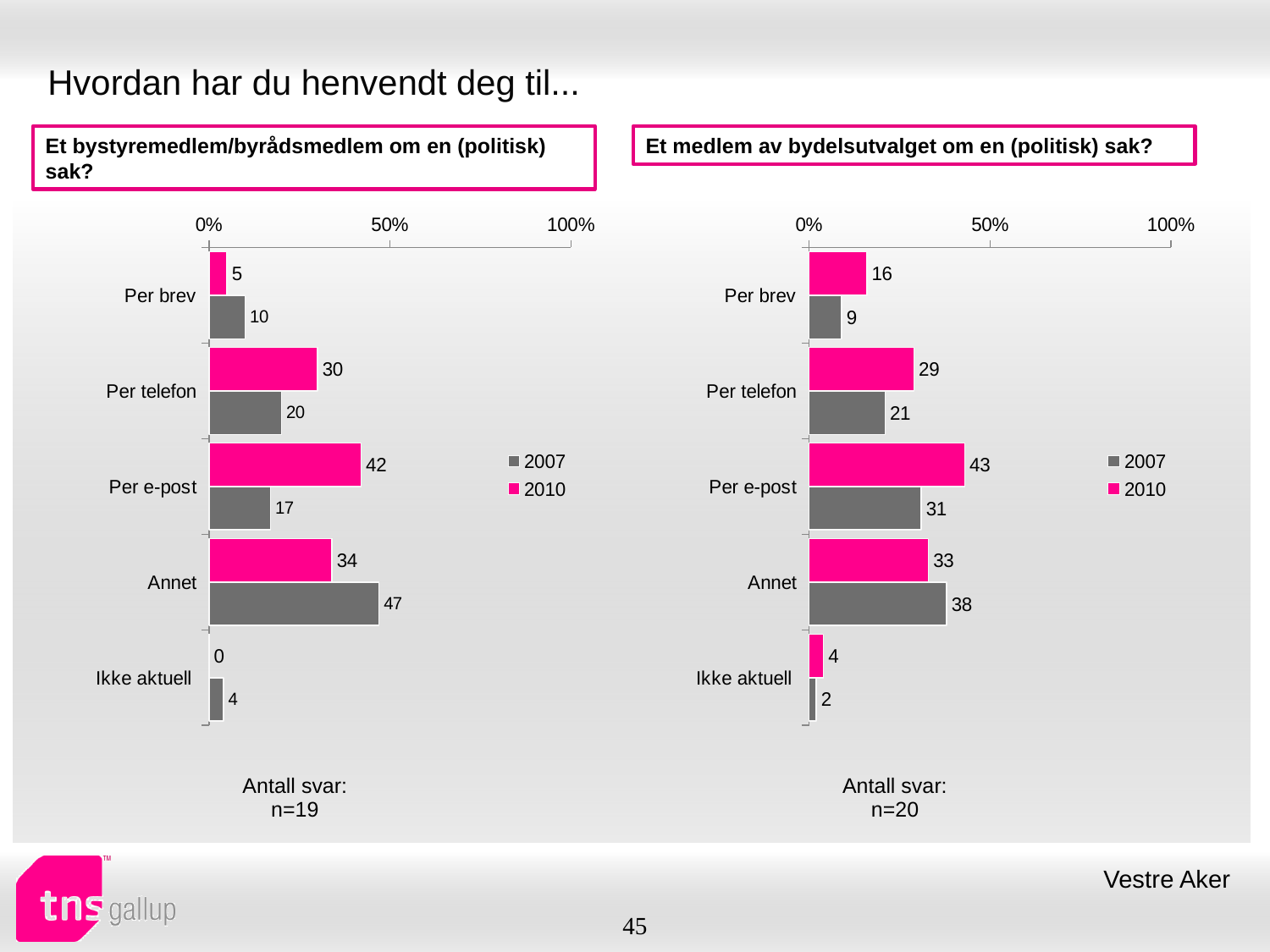
How many categories are shown in the right chart (Et medlem av bydelsutvalget om en (politisk) sak?)? 5 In the right chart (Et medlem av bydelsutvalget om en (politisk) sak?), what is the 2007 value for Per e-post? 31 In the left chart (Et bystyremedlem/byrådsmedlem om en (politisk) sak?), which category has the lowest 2010 value? Ikke aktuell What type of chart is the right chart (Et medlem av bydelsutvalget om en (politisk) sak?)? Bar chart In the right chart (Et medlem av bydelsutvalget om en (politisk) sak?), what is the difference between the 2010 and 2007 values for Per brev? 7 In the left chart (Et bystyremedlem/byrådsmedlem om en (politisk) sak?), what is the difference between the 2007 and 2010 values for Annet? 13 How many series does the legend of the left chart (Et bystyremedlem/byrådsmedlem om en (politisk) sak?) list? 2 In the left chart (Et bystyremedlem/byrådsmedlem om en (politisk) sak?), what is the 2007 value for Annet? 47 In the right chart (Et medlem av bydelsutvalget om en (politisk) sak?), which category has the highest 2010 value? Per e-post In the left chart (Et bystyremedlem/byrådsmedlem om en (politisk) sak?), is the 2010 value for Per e-post greater or less than 50%? less In the left chart (Et bystyremedlem/byrådsmedlem om en (politisk) sak?), what is the 2010 value for Per e-post? 42 In the right chart (Et medlem av bydelsutvalget om en (politisk) sak?), which is larger for Per telefon: the 2007 value or the 2010 value? 2010